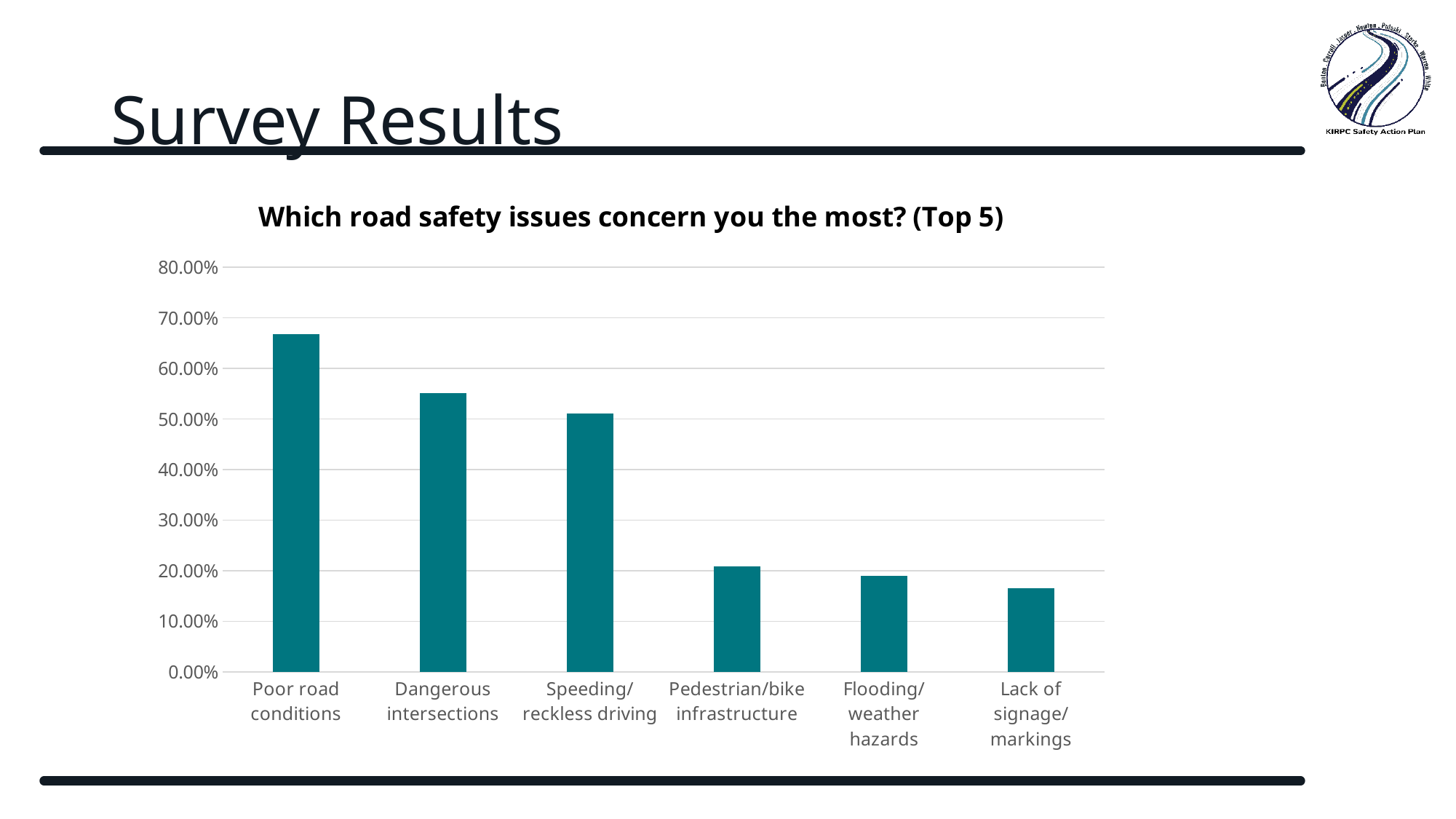
How many categories are plotted on the chart? 6 Is the value for Flooding/weather hazards greater or less than 20.00%? less Which is larger, the value for Dangerous intersections or the value for Pedestrian/bike infrastructure? Dangerous intersections Do the values rise or fall moving from left to right along the x axis? Fall Which road safety issue has the highest value? Poor road conditions Is the value for Speeding/reckless driving greater or less than 60.00%? less Which road safety issue has the lowest value? Lack of signage/markings Is the value for Poor road conditions greater or less than 60.00%? greater What kind of chart is shown on the slide? Bar chart What is the title of the chart? Which road safety issues concern you the most? (Top 5)